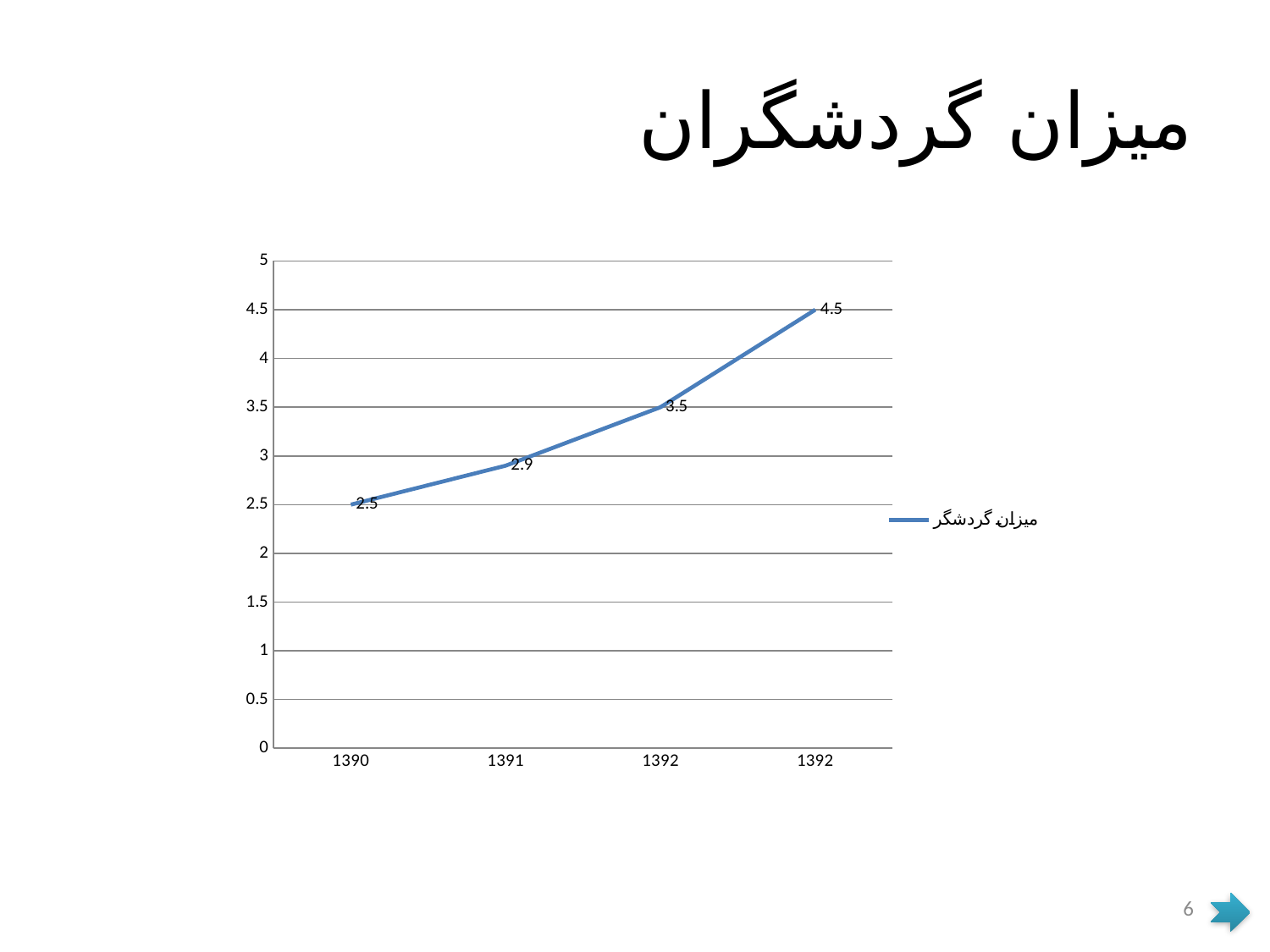
What is the value for 1390? 2.5 What is the difference between the last point (4.5) and the third point (3.5)? 1 What is the value of the third point from the left on the line? 3.5 What is the value of the last (rightmost) point on the line? 4.5 How many data points are plotted on the line? 4 What type of chart is shown on the slide? line chart What is the value for 1391? 2.9 Which x-axis category has the lowest value? 1390 What is the highest value plotted on the chart? 4.5 What is the difference between the value for 1391 and the value for 1390? 0.4 Do the values rise or fall from left to right along the x axis? rise Which is larger, the value for 1390 or the value for 1391? 1391